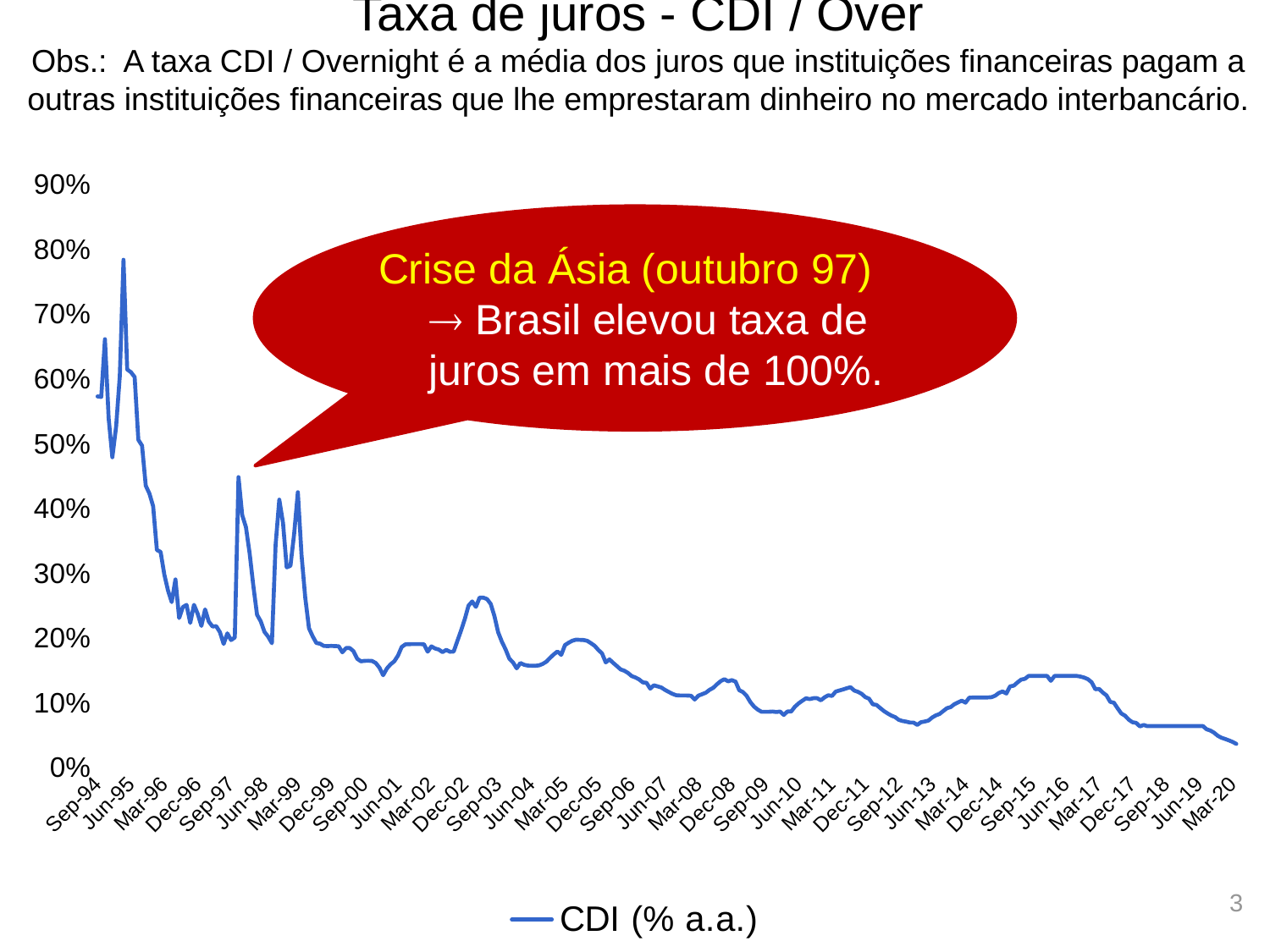
Is the highest CDI value on the chart greater or less than 70%? greater How many series does the legend list? 1 Is the CDI value at Sep-09 greater or less than 20%? less What is the title of the chart? Taxa de juros - CDI / Over Is the CDI value at Mar-20 greater or less than 10%? less Overall, does the CDI rate rise or fall from Sep-94 to Mar-20? fall Which is larger, the CDI value at Sep-94 or at Mar-20? Sep-94 What is the name of the series shown in the legend? CDI (% a.a.) What kind of chart is shown on the slide? line chart What is the highest value shown on the vertical axis? 90%